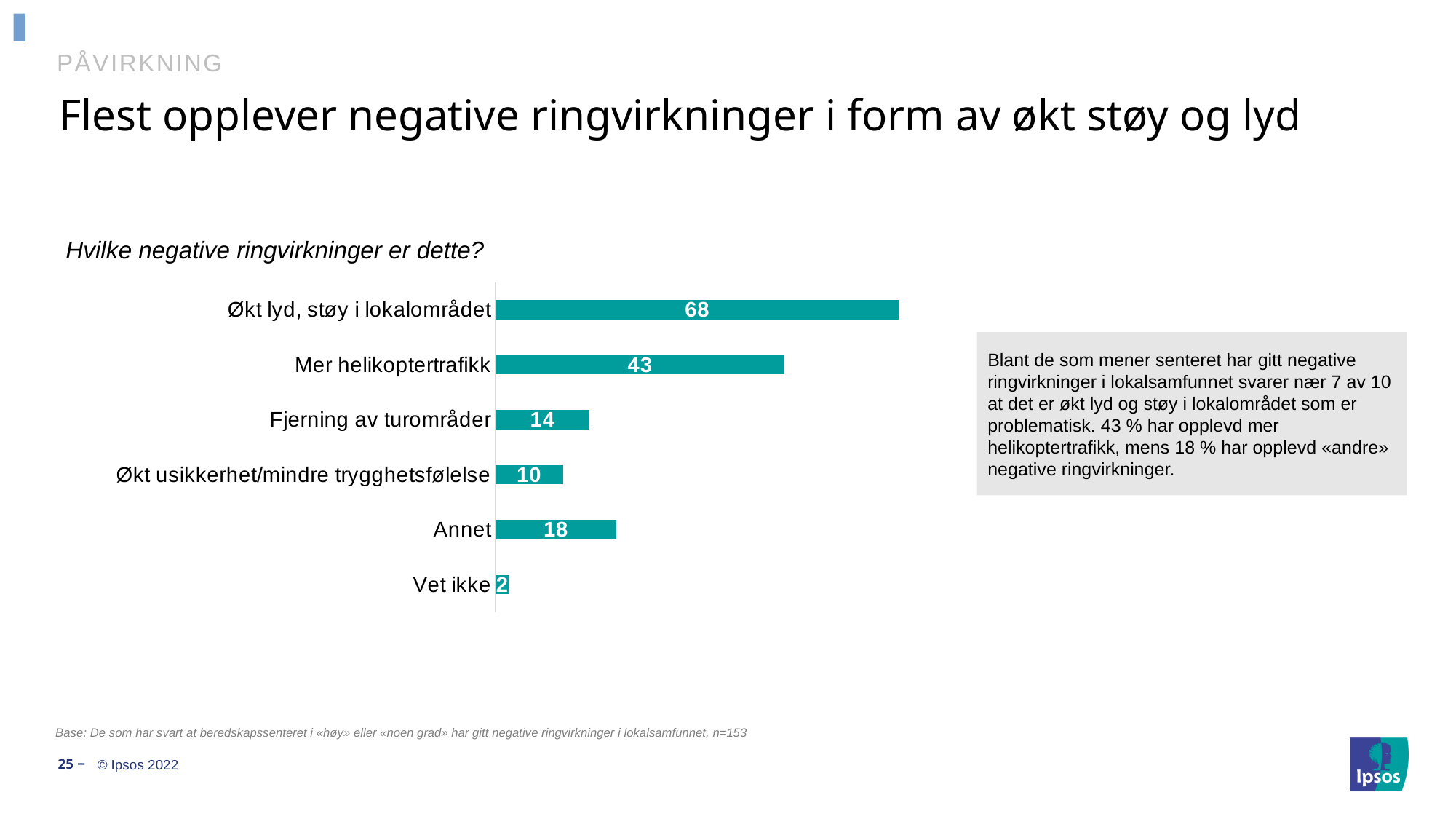
Which category has the highest value? Økt lyd, støy i lokalområdet Which category has the lowest value? Vet ikke What kind of chart is shown on the slide? Bar chart What is the value for "Økt lyd, støy i lokalområdet"? 68 What is the value for "Økt usikkerhet/mindre trygghetsfølelse"? 10 What is the value for "Fjerning av turområder"? 14 What is the difference between the values for "Økt lyd, støy i lokalområdet" and "Mer helikoptertrafikk"? 25 How many categories are shown in the chart? 6 What is the value for "Vet ikke"? 2 What is the value for "Mer helikoptertrafikk"? 43 What is the value for "Annet"? 18 Which is larger, the value for "Annet" or the value for "Fjerning av turområder"? Annet